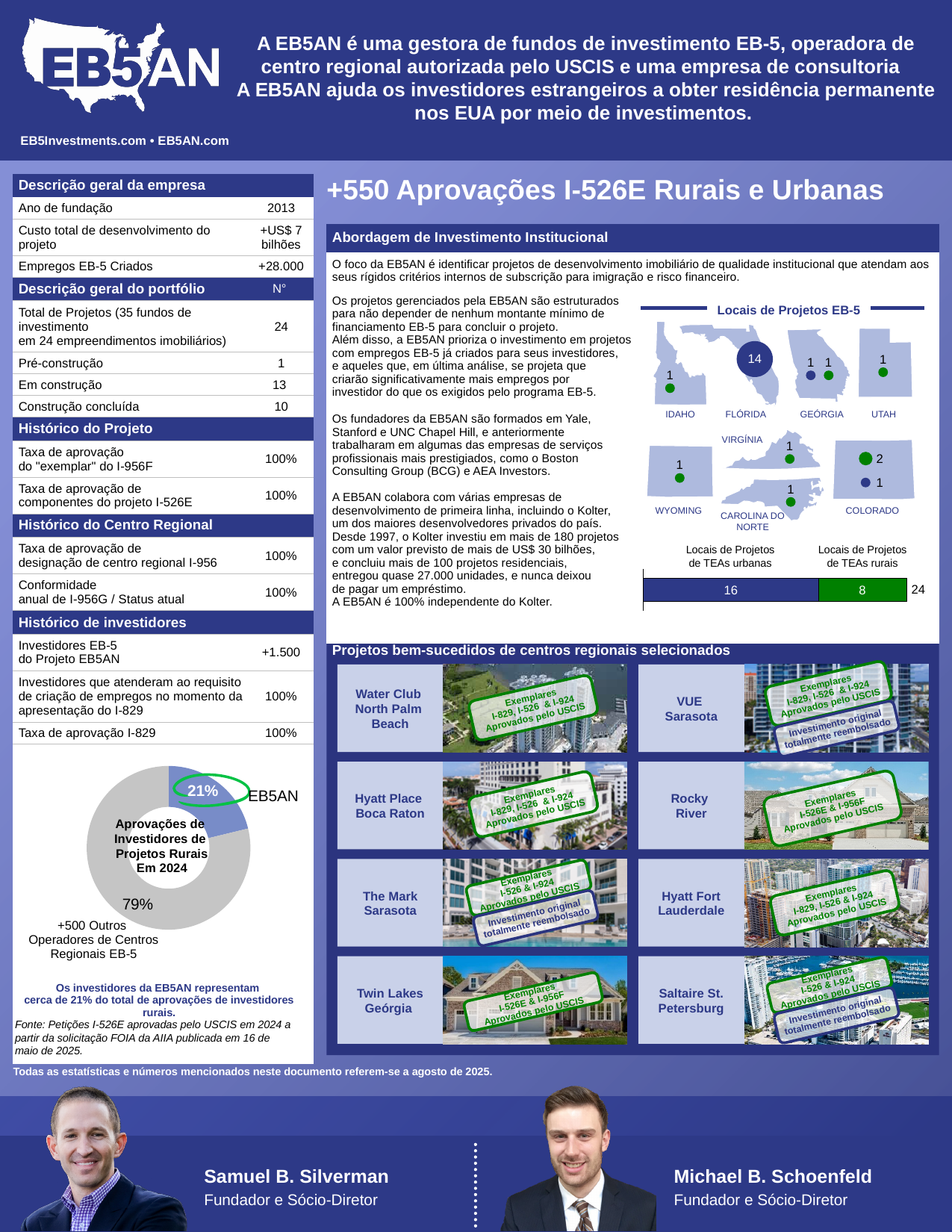
In the stacked bar chart under 'Locais de Projetos EB-5', what is the value for 'Locais de Projetos de TEAs urbanas'? 16 In the stacked bar chart under 'Locais de Projetos EB-5', what colour is the rural TEA segment? Green What kind of chart is 'Aprovações de Investidores de Projetos Rurais Em 2024'? Donut (pie) chart In the stacked bar chart under 'Locais de Projetos EB-5', what is the difference between the urban TEA and rural TEA project counts? 8 In the donut chart 'Aprovações de Investidores de Projetos Rurais Em 2024', what share is attributed to '+500 Outros Operadores de Centros Regionais EB-5'? 79% In the donut chart 'Aprovações de Investidores de Projetos Rurais Em 2024', what share is attributed to EB5AN? 21% In the donut chart 'Aprovações de Investidores de Projetos Rurais Em 2024', what is the difference in percentage points between the '+500 Outros' segment and the EB5AN segment? 58 In the stacked bar chart under 'Locais de Projetos EB-5', which segment is larger: urban TEAs or rural TEAs? Locais de Projetos de TEAs urbanas In the donut chart 'Aprovações de Investidores de Projetos Rurais Em 2024', how many segments are shown? 2 In the donut chart 'Aprovações de Investidores de Projetos Rurais Em 2024', which segment is larger: EB5AN or '+500 Outros Operadores de Centros Regionais EB-5'? +500 Outros Operadores de Centros Regionais EB-5 In the stacked bar chart under 'Locais de Projetos EB-5', what is the value for 'Locais de Projetos de TEAs rurais'? 8 In the stacked bar chart under 'Locais de Projetos EB-5', what is the total of the bar? 24